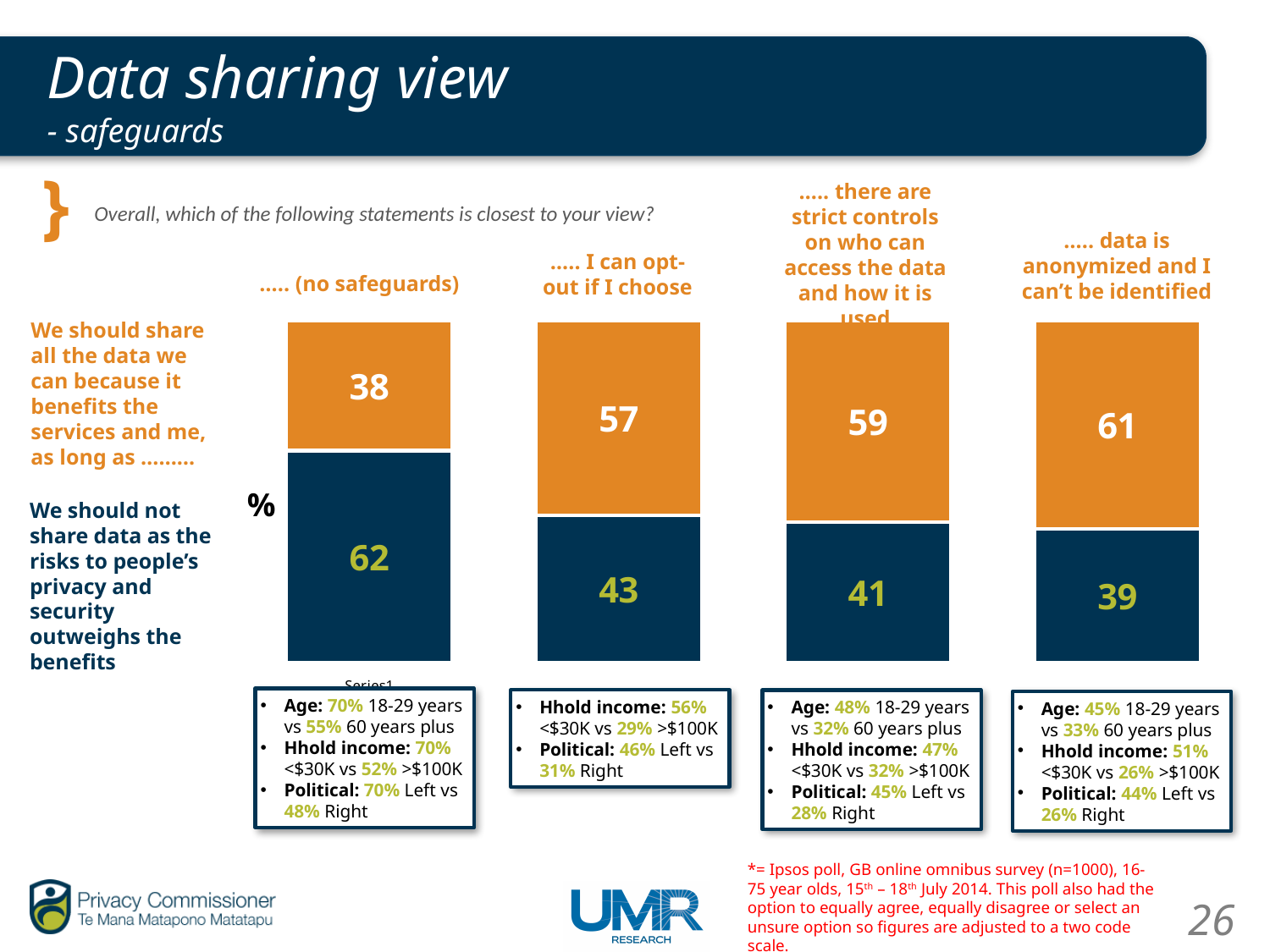
What kind of chart is shown on the slide? stacked bar chart Which is larger: the dark blue value for 'I can opt-out if I choose' or the dark blue value for 'there are strict controls on who can access the data and how it is used'? I can opt-out if I choose What is the value of the dark blue segment (should not share data) for the '(no safeguards)' bar? 62 What is the value of the orange segment for the 'I can opt-out if I choose' bar? 57 Which safeguard condition has the highest orange (share all the data) value? data is anonymized and I can't be identified How many stacked bars (safeguard conditions) are plotted in the chart? 4 What is the value of the dark blue segment for the 'data is anonymized and I can't be identified' bar? 39 What is the difference between the orange values for 'data is anonymized and I can't be identified' and '(no safeguards)'? 23 Which condition has the lowest orange (share all the data) value? (no safeguards) Do the orange (share all the data) values rise or fall moving from left to right across the bars? rise What is the total of the two segments in the 'there are strict controls' bar? 100 What is the value of the orange segment (share all the data) for the '(no safeguards)' bar? 38